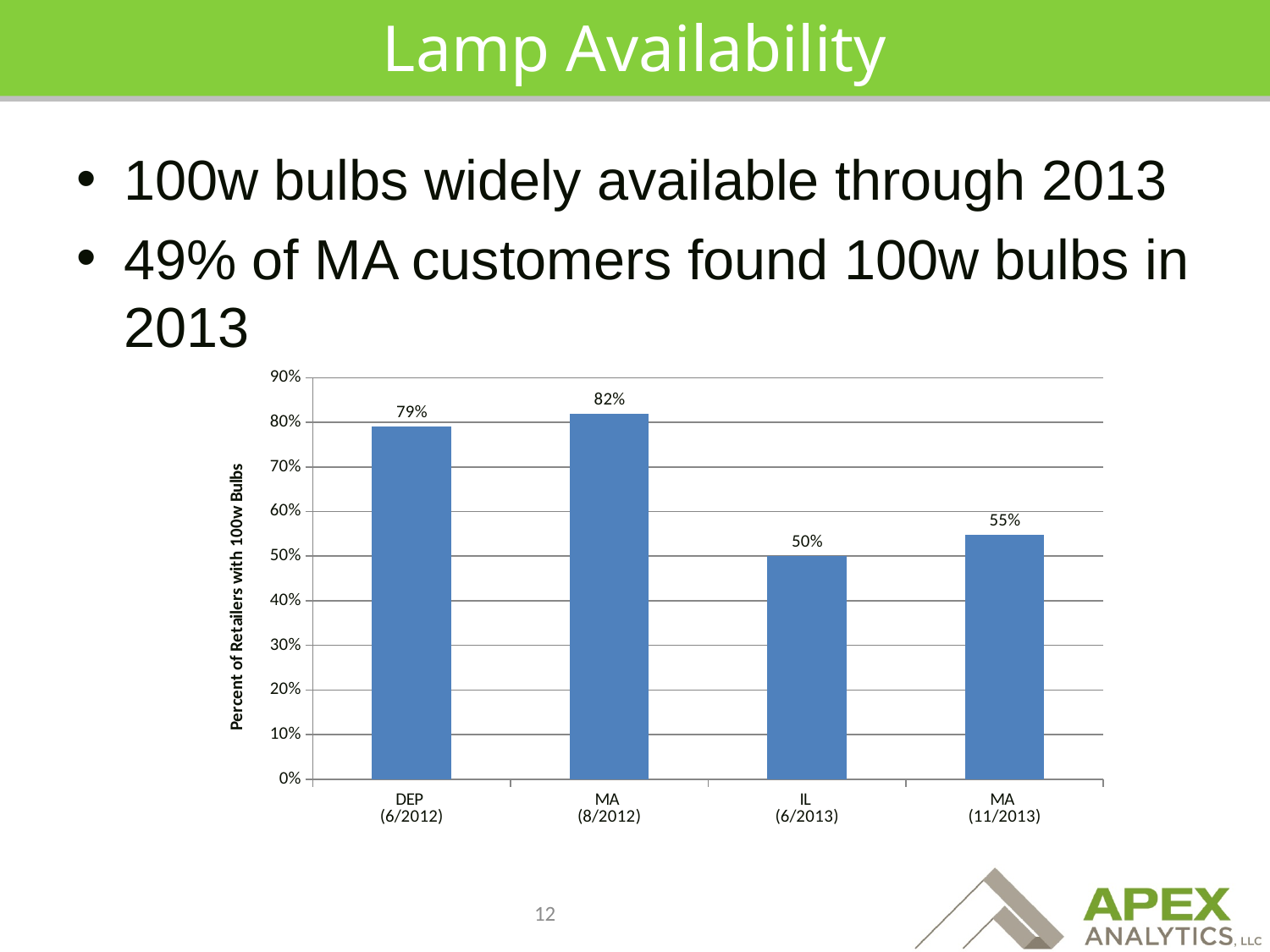
Is the value for MA (11/2013) greater or less than 60%? less What is the value for DEP (6/2012)? 79% What is the label of the vertical axis? Percent of Retailers with 100w Bulbs What kind of chart is shown on the slide? bar chart How many categories are shown on the x axis? 4 What is the difference between the values for MA (8/2012) and MA (11/2013)? 27% What is the value for MA (8/2012)? 82% What is the value for IL (6/2013)? 50% Which is larger, the value for DEP (6/2012) or the value for IL (6/2013)? DEP (6/2012) Which category has the highest value? MA (8/2012) Which category has the lowest value? IL (6/2013) What is the value for MA (11/2013)? 55%